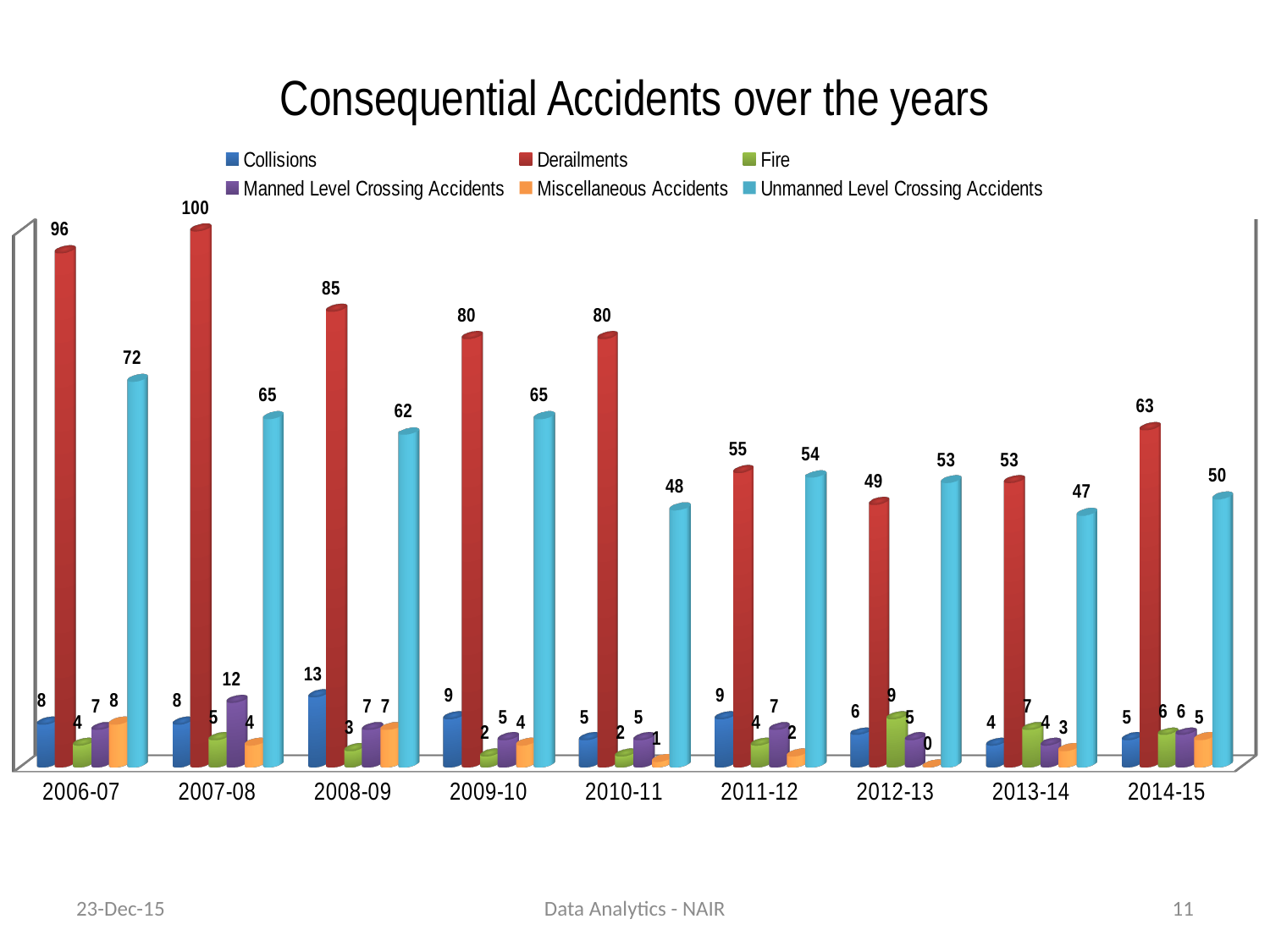
How many years are shown on the x axis? 9 How many series does the legend list? 6 In which year is the Unmanned Level Crossing Accidents value lowest? 2013-14 What is the value for Collisions in 2008-09? 13 What is the difference between Derailments in 2006-07 and Derailments in 2014-15? 33 What kind of chart is shown on the slide? Bar chart What is the value for Unmanned Level Crossing Accidents in 2006-07? 72 What is the value for Manned Level Crossing Accidents in 2007-08? 12 Which is larger in 2011-12: Derailments or Unmanned Level Crossing Accidents? Derailments In which year is the Derailments value highest? 2007-08 What is the value for Derailments in 2007-08? 100 Does the Derailments value rise or fall from 2007-08 to 2012-13? Fall